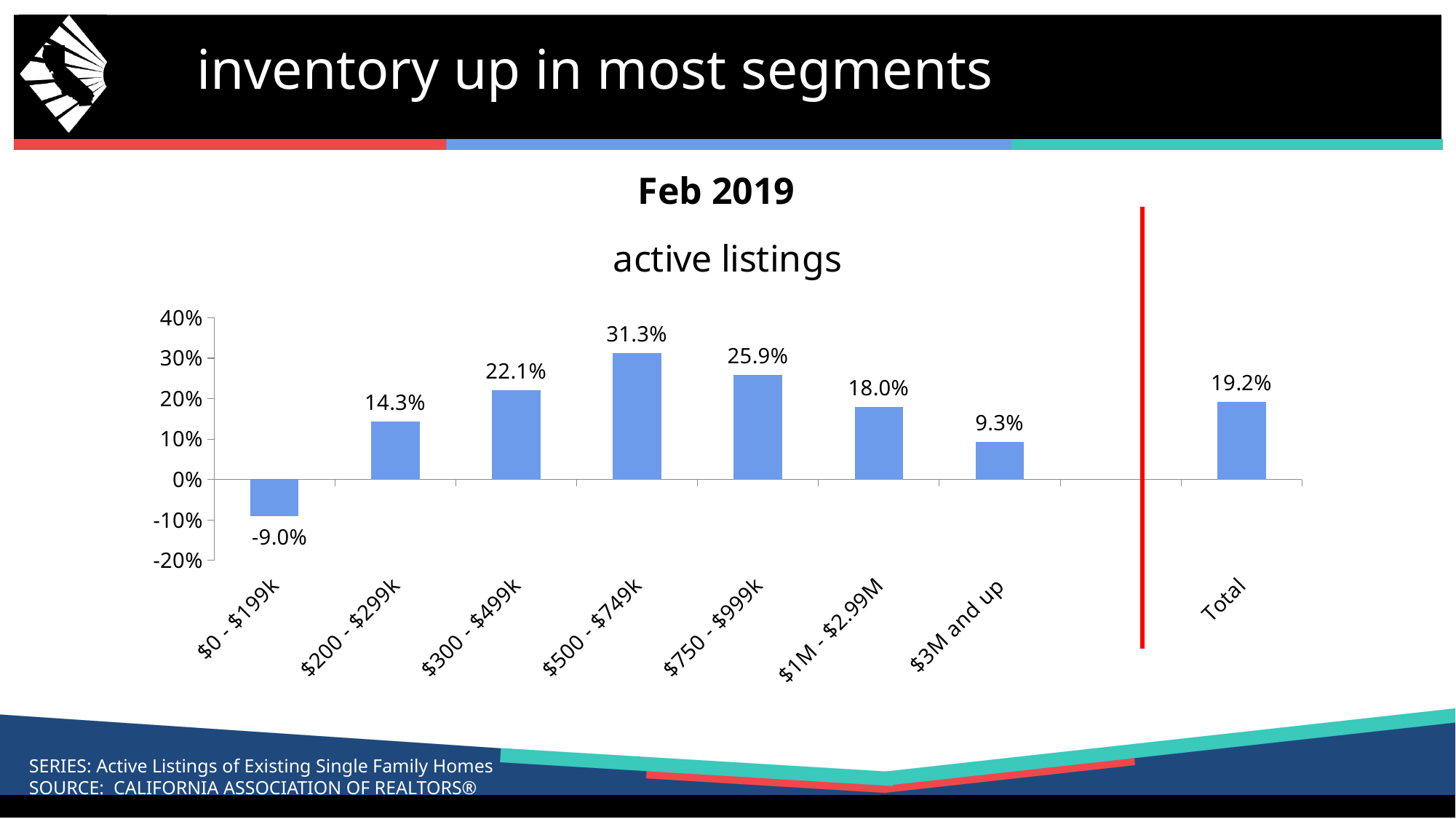
What is the value for the $500 - $749k segment? 31.3% What is the value for the $0 - $199k segment? -9.0% What kind of chart is shown on the slide? bar chart What is the difference between the $500 - $749k value and the $750 - $999k value? 5.4% Which is larger, the value for $200 - $299k or the value for $1M - $2.99M? $1M - $2.99M What is the title of the chart? active listings Which price segment has the highest value? $500 - $749k Which price segment has the lowest value? $0 - $199k What is the value for the $3M and up segment? 9.3% How many bars are plotted on the chart, including Total? 8 Is the value for $300 - $499k greater or less than 20%? greater What is the value shown for Total? 19.2%